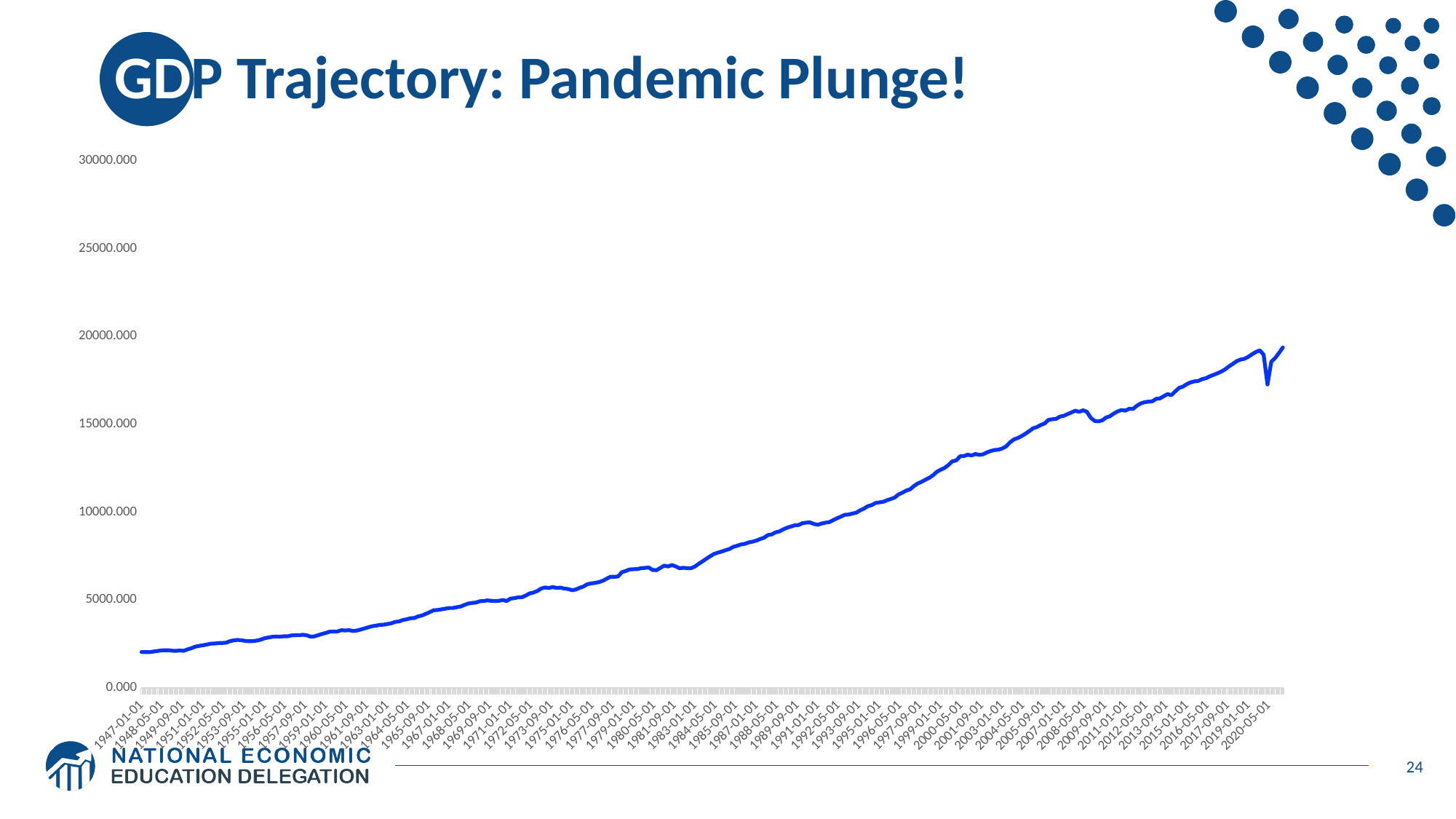
Is the value at 1965-09-01 greater or less than 5000? less What is the highest tick value shown on the y axis? 30000.000 What kind of chart is shown on the slide? line chart Is the value at 2020-05-01 greater or less than 15000? greater Is the value at 1984-05-01 larger or smaller than the value at 1999-01-01? smaller Is the value at 2013-09-01 greater or less than 15000? greater Overall, do the values rise or fall along the x axis from 1947 to 2020? rise What is the title of the slide's chart? GDP Trajectory: Pandemic Plunge!